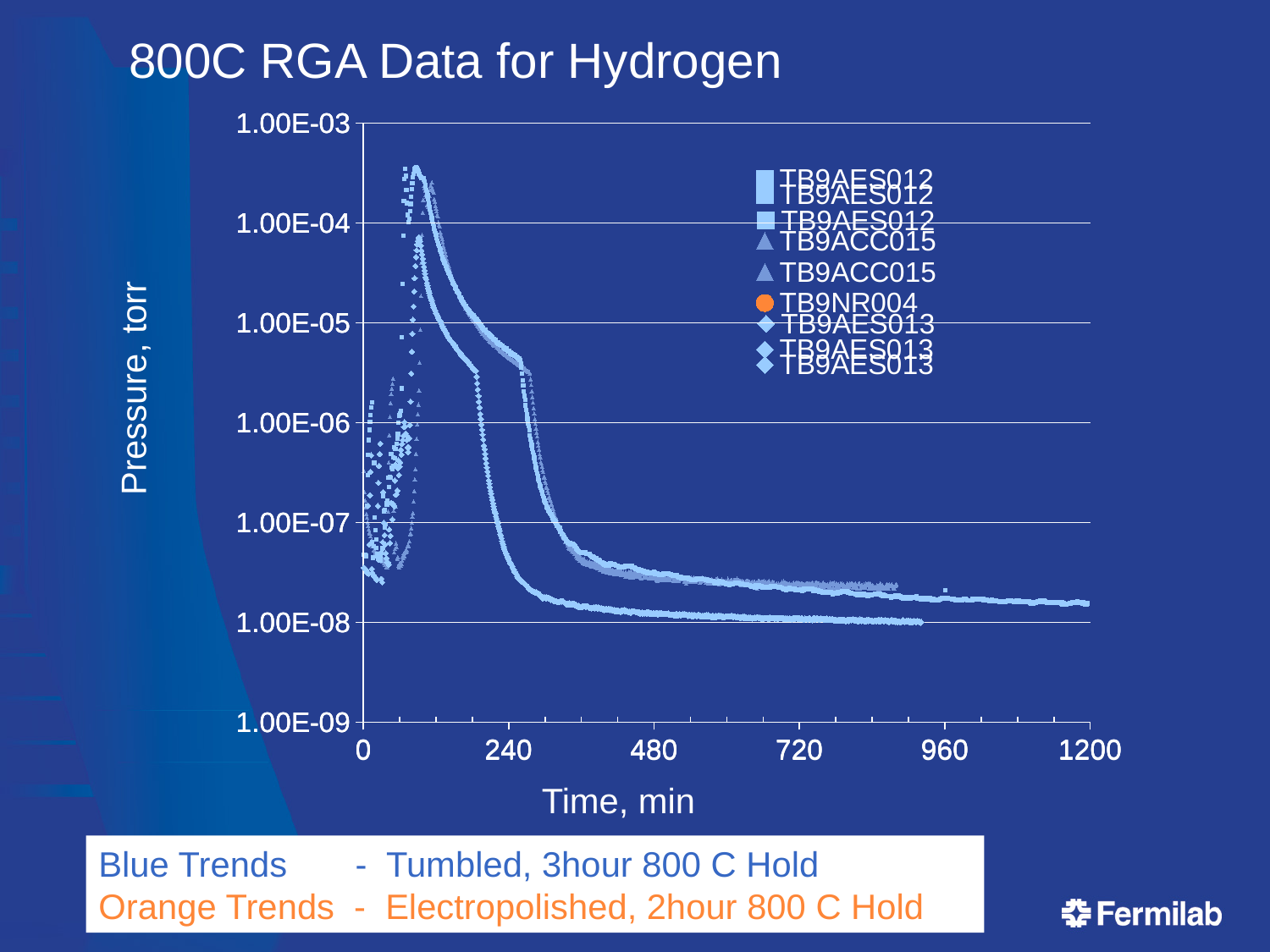
What type of chart is shown on the slide? scatter chart At 1200 minutes, is the pressure of the longest-running curve greater or less than 1.00E-07 torr? less What is the highest value shown on the y-axis? 1.00E-03 Which legend entry is shown with an orange marker? TB9NR004 How many entries does the chart legend list? 9 At 240 minutes, is the pressure of the highest curve greater or less than 1.00E-06 torr? greater What is the title of the chart? 800C RGA Data for Hydrogen What is the largest time value labelled on the x-axis? 1200 What is the label of the y-axis? Pressure, torr After the initial peak near 100 minutes, do the pressure values rise or fall as time increases? fall Is the peak pressure reached by the curves greater or less than 1.00E-04 torr? greater